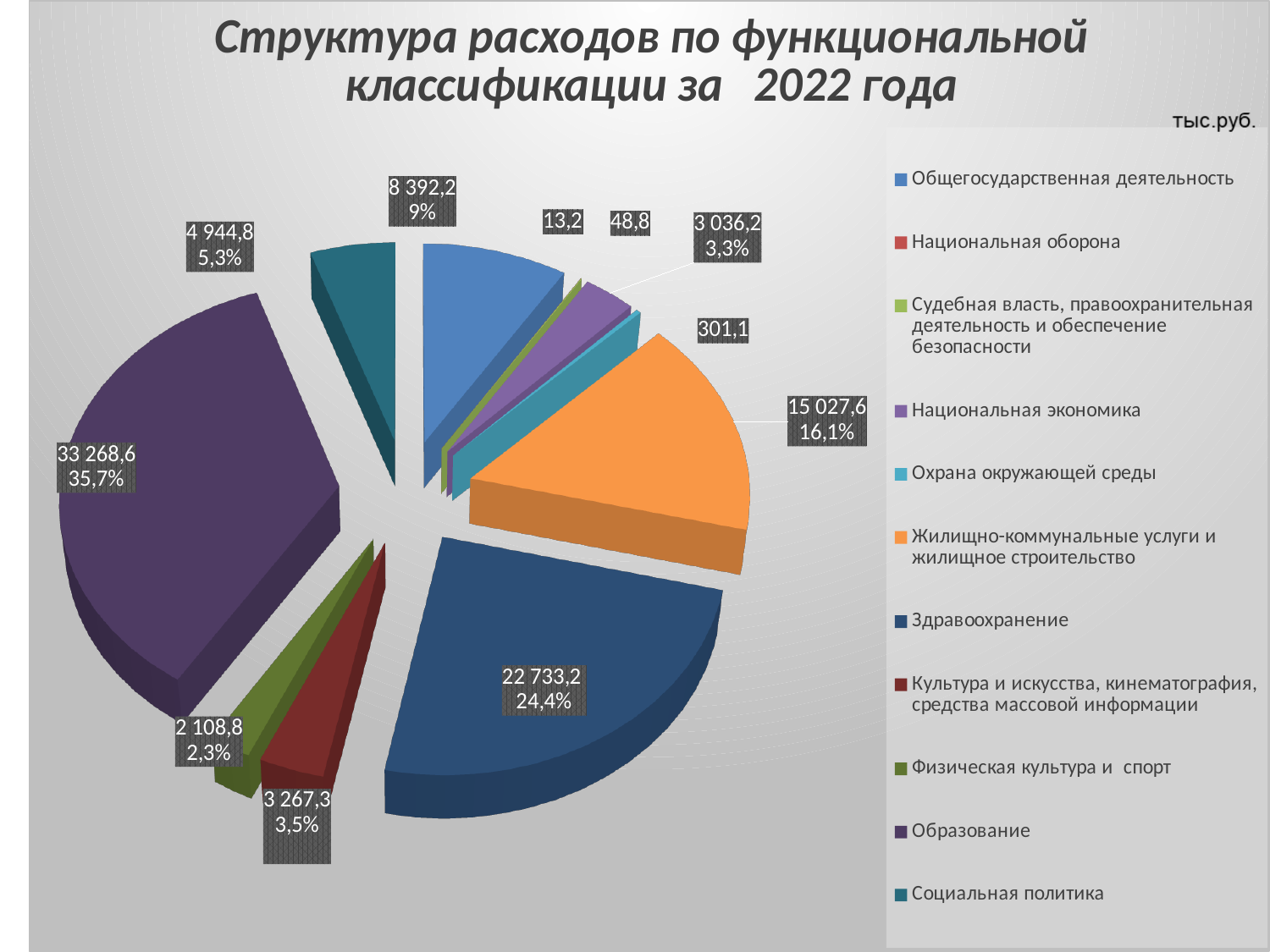
In what units are the values on the chart given? тыс.руб. Which is larger: Здравоохранение or Жилищно-коммунальные услуги и жилищное строительство? Здравоохранение What is the value for Здравоохранение? 22 733,2 What share of the pie does Образование account for? 35,7% How many categories does the legend of the pie chart list? 11 What type of chart is shown on the slide? pie chart What is the difference between the values for Культура и искусства, кинематография, средства массовой информации and Физическая культура и спорт? 1 158,5 Which category has the largest slice of the pie? Образование What is the difference between the values for Образование and Здравоохранение? 10 535,4 What share of the pie does Жилищно-коммунальные услуги и жилищное строительство account for? 16,1% What is the value for Социальная политика? 4 944,8 What is the value for Образование? 33 268,6